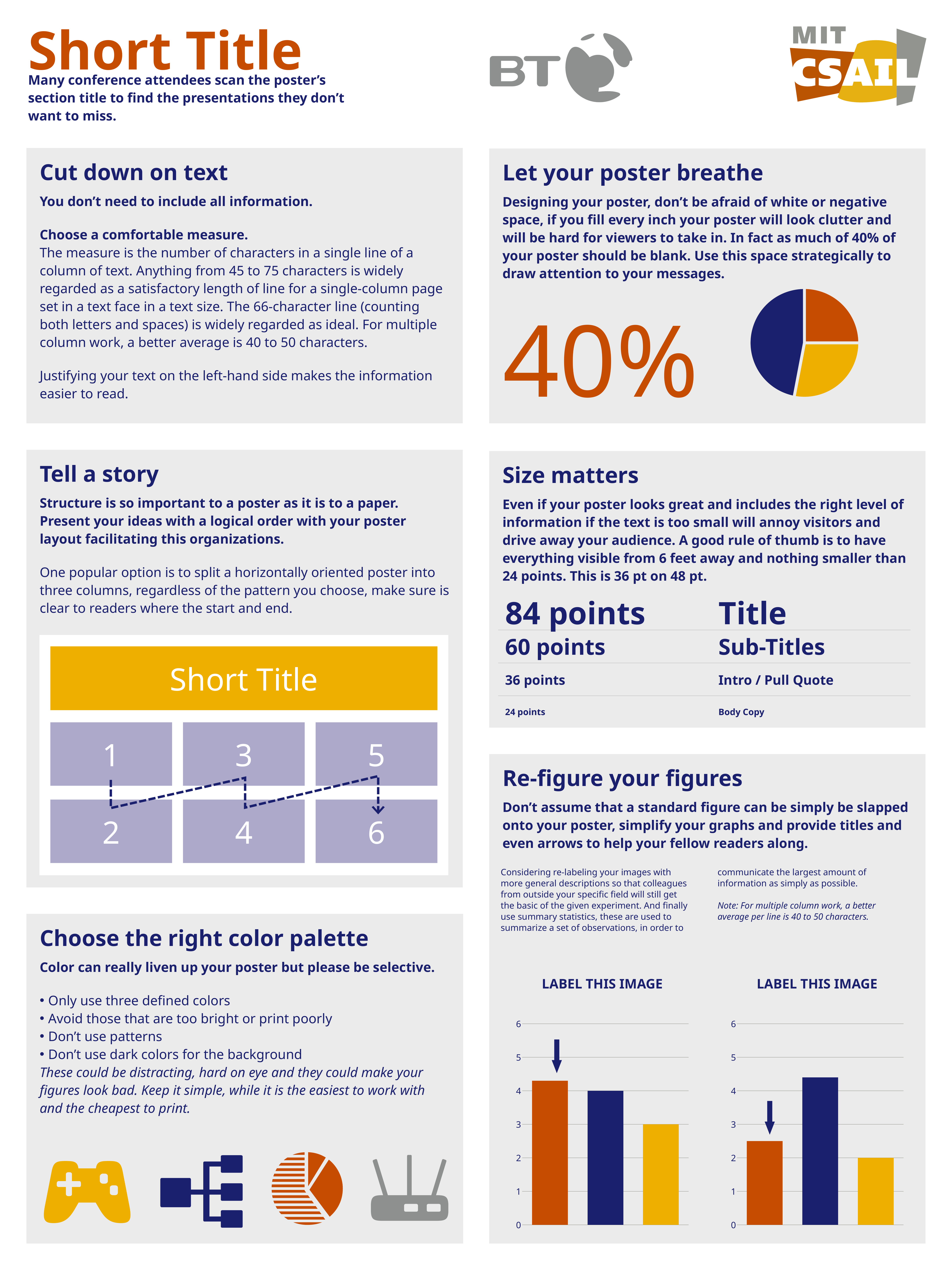
In the right 'LABEL THIS IMAGE' chart, which bar is the highest? the dark blue (middle) bar In the left 'LABEL THIS IMAGE' chart, what value does the yellow (right) bar reach? 3 What kind of chart is the left 'LABEL THIS IMAGE' chart at the bottom right of the slide? bar chart How many slices does the pie chart in the 'Let your poster breathe' section have? 3 In the right 'LABEL THIS IMAGE' chart, is the value of the orange (left) bar greater or less than 3? less In the left 'LABEL THIS IMAGE' chart, what value does the dark blue (middle) bar reach? 4 In the left 'LABEL THIS IMAGE' chart, is the value of the orange (left) bar greater or less than 4? greater Which colour slice is the largest in the pie chart in the 'Let your poster breathe' section? dark blue In the right 'LABEL THIS IMAGE' chart, what value does the yellow (right) bar reach? 2 What kind of chart is shown in the 'Let your poster breathe' section? pie chart How many bars does the left 'LABEL THIS IMAGE' chart have? 3 In the left 'LABEL THIS IMAGE' chart, which bar is the lowest? the yellow (right) bar